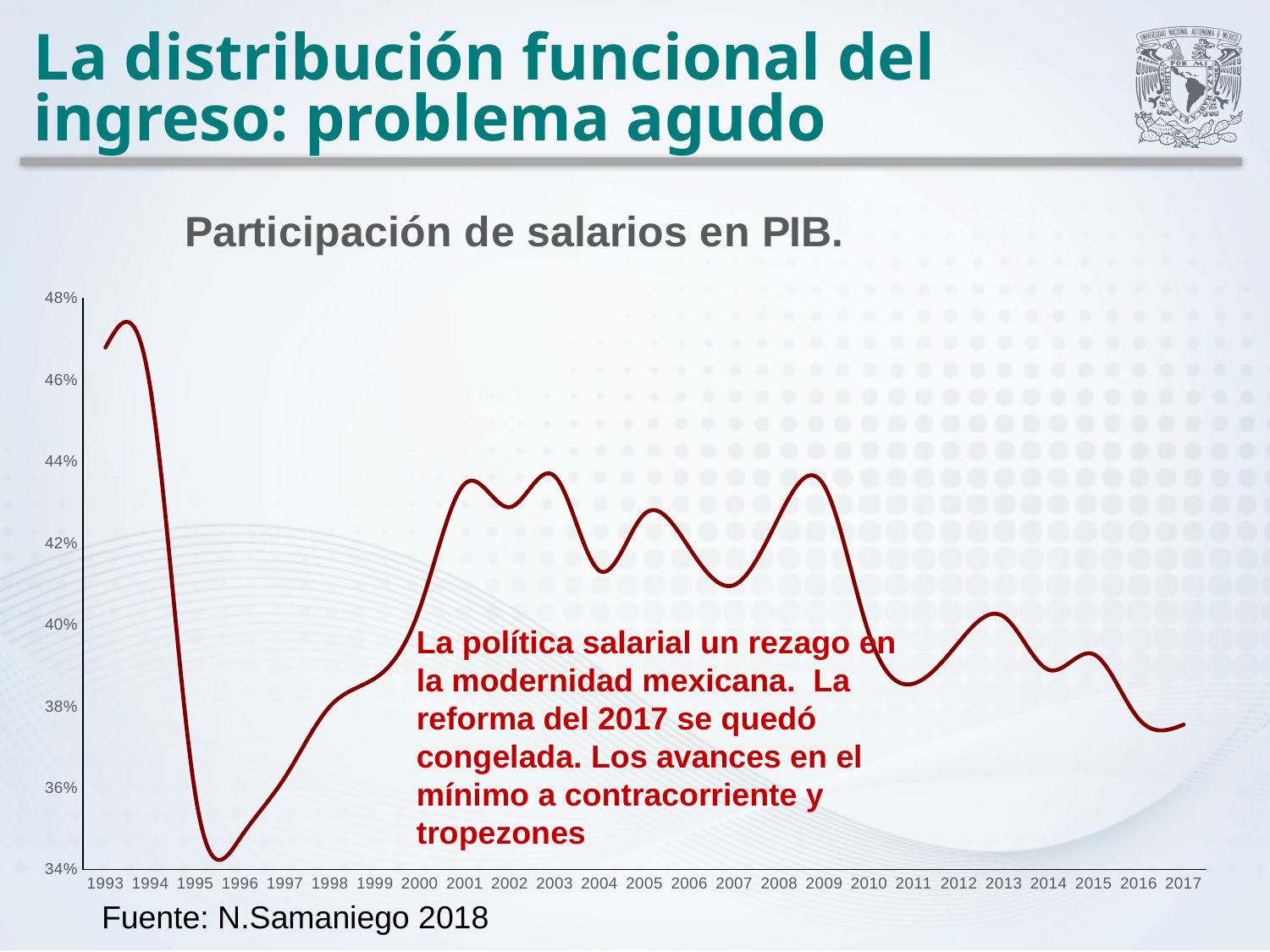
Is the value for 2017 greater or less than 38%? less What is the title of the chart? Participación de salarios en PIB. Is the value for 2003 greater or less than 42%? greater Which year has the higher value, 1996 or 2013? 2013 Which year has the higher value, 1994 or 2017? 1994 What kind of chart is shown on the slide? line chart Is the value for 1996 greater or less than 36%? less Overall, does the wage share of GDP rise or fall between 1993 and 2017? fall How many years are shown on the x axis of the chart? 25 In which year does the line reach its lowest value? 1996 In which year does the line reach its highest value? 1993